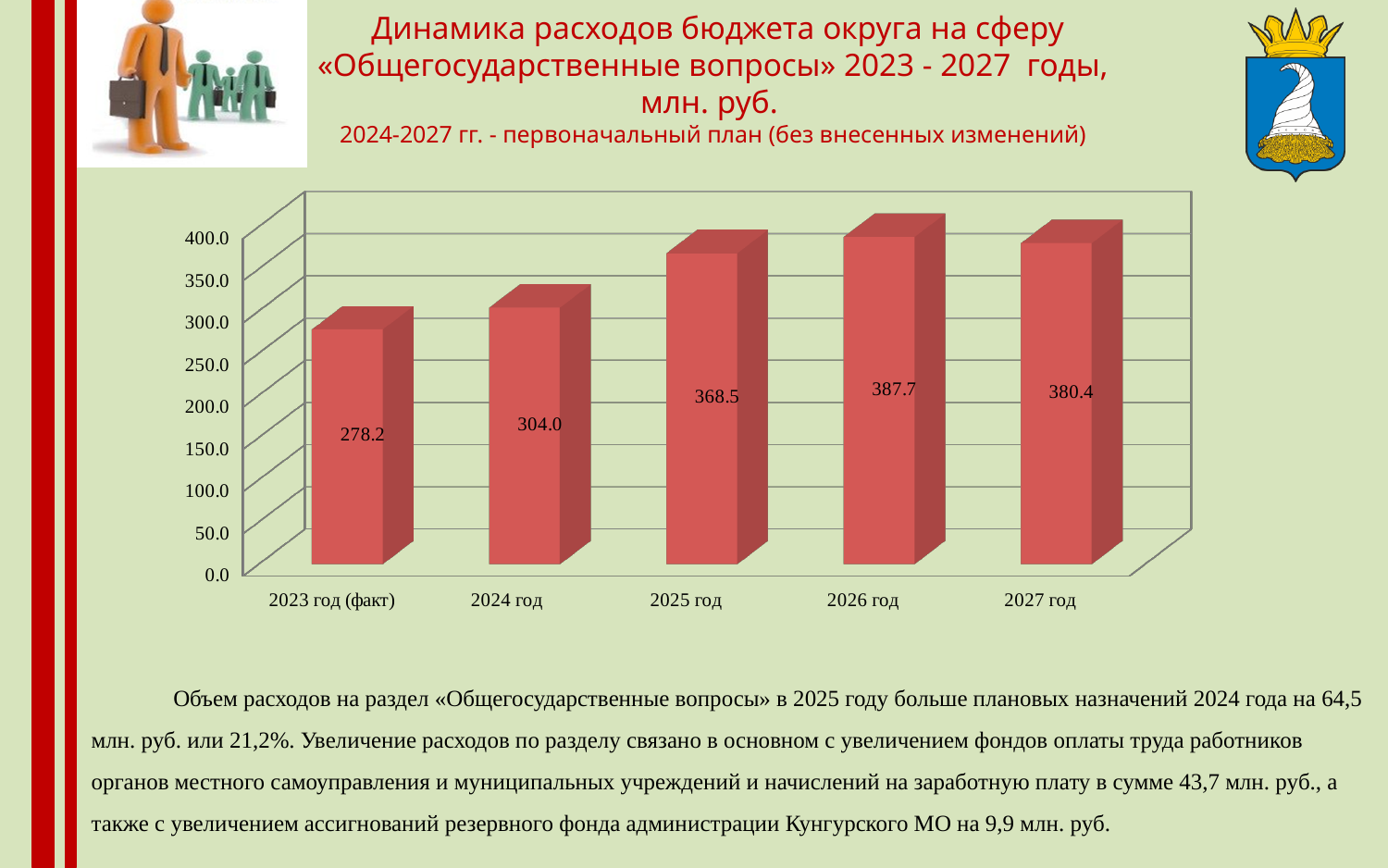
What is the value for 2025 год? 368.5 Is the value for 2026 год greater or less than 350.0? greater What kind of chart is shown on the slide? bar chart What is the value for 2027 год? 380.4 How many years are shown on the x axis? 5 Which is larger, the value for 2024 год or the value for 2023 год (факт)? 2024 год What is the difference between the values for 2026 год and 2027 год? 7.3 Which year has the lowest value? 2023 год (факт) What is the value for 2023 год (факт)? 278.2 Which year has the highest value? 2026 год Do the values rise or fall from 2023 год (факт) to 2026 год? rise What is the difference between the values for 2025 год and 2024 год? 64.5